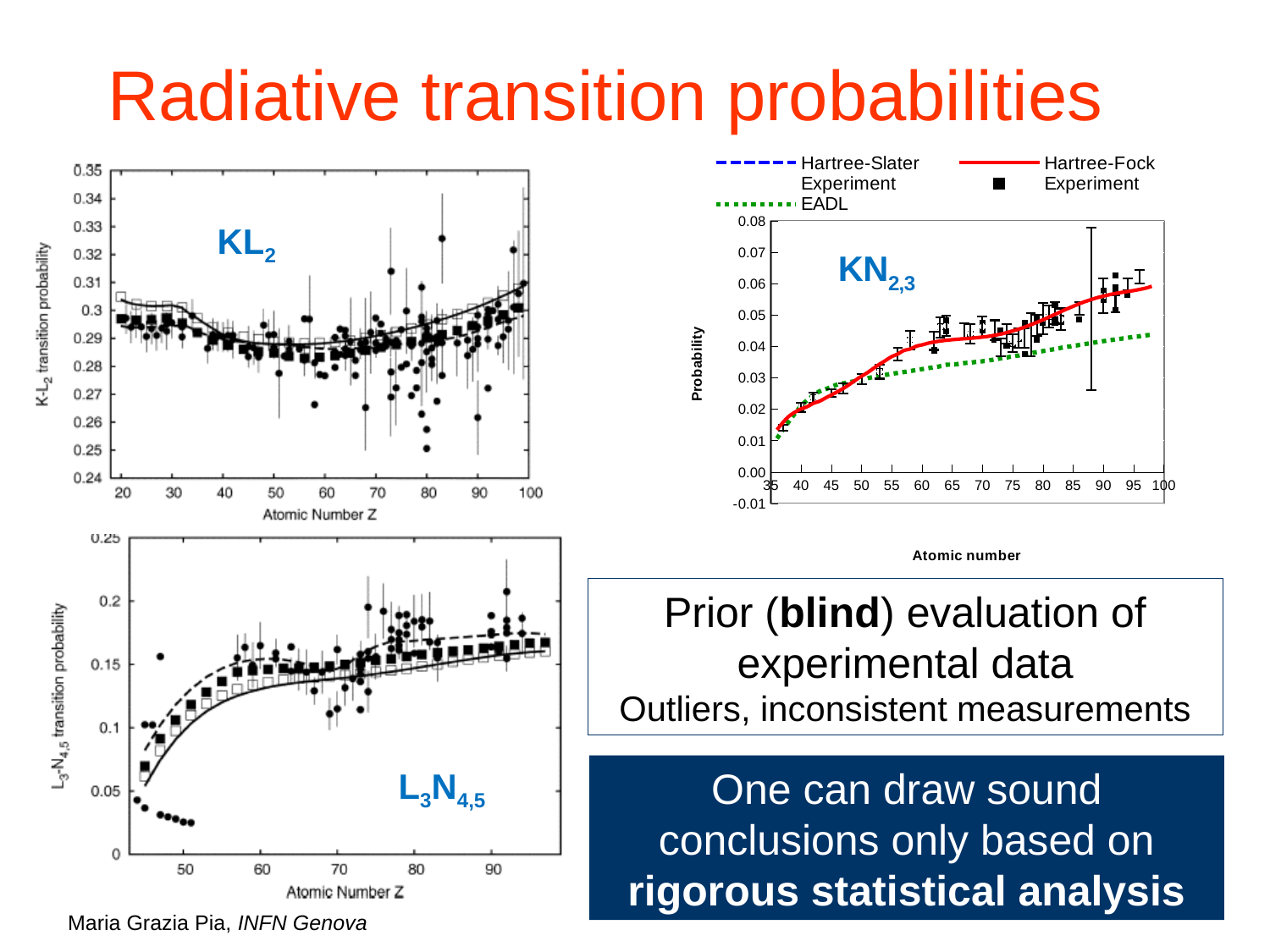
What is the label of the x axis of the KN2,3 chart? Atomic number In the KL2 chart at the top left, is the solid-curve value at atomic number 50 greater or less than 0.3? less In the KN2,3 chart, is the Hartree-Fock value at atomic number 95 greater or less than 0.05? greater In the KN2,3 chart, at atomic number 90, which is larger: the Hartree-Fock curve or the EADL curve? Hartree-Fock In the L3N4,5 chart at the bottom left, do the transition probability values generally rise or fall as the atomic number increases? rise In the L3N4,5 chart, is the solid-curve value at atomic number 90 greater or less than 0.1? greater What kind of chart is the KN2,3 chart on the right of the slide? line chart In the KL2 chart, which is larger: the solid-curve value at atomic number 20 or at atomic number 50? atomic number 20 What is the label of the y axis of the KN2,3 chart? Probability In the KN2,3 chart, does the Hartree-Fock curve rise or fall as the atomic number increases? rise